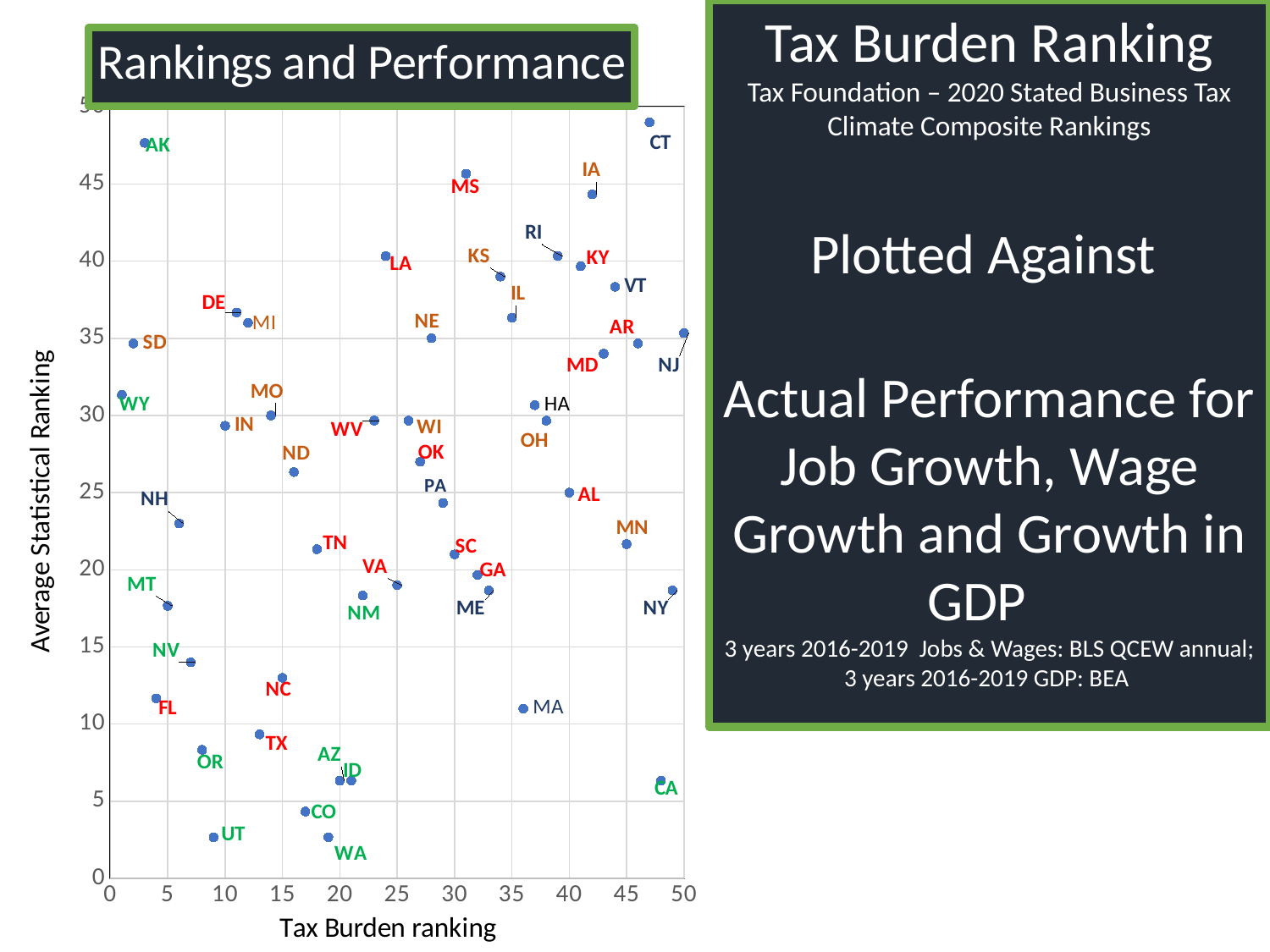
Is the Average Statistical Ranking for WA greater or less than 5? less Is the Average Statistical Ranking for AK greater or less than 45? greater Is the Average Statistical Ranking for IA greater or less than 40? greater What is the title of the y axis of the chart? Average Statistical Ranking Which has the higher Average Statistical Ranking, FL or TN? TN Which has the larger Tax Burden ranking, WY or NJ? NJ What is the title of the x axis of the chart? Tax Burden ranking Which state has the highest Average Statistical Ranking on the chart? CT What kind of chart is shown on the slide? Scatter plot Which has the higher Average Statistical Ranking, MS or LA? MS